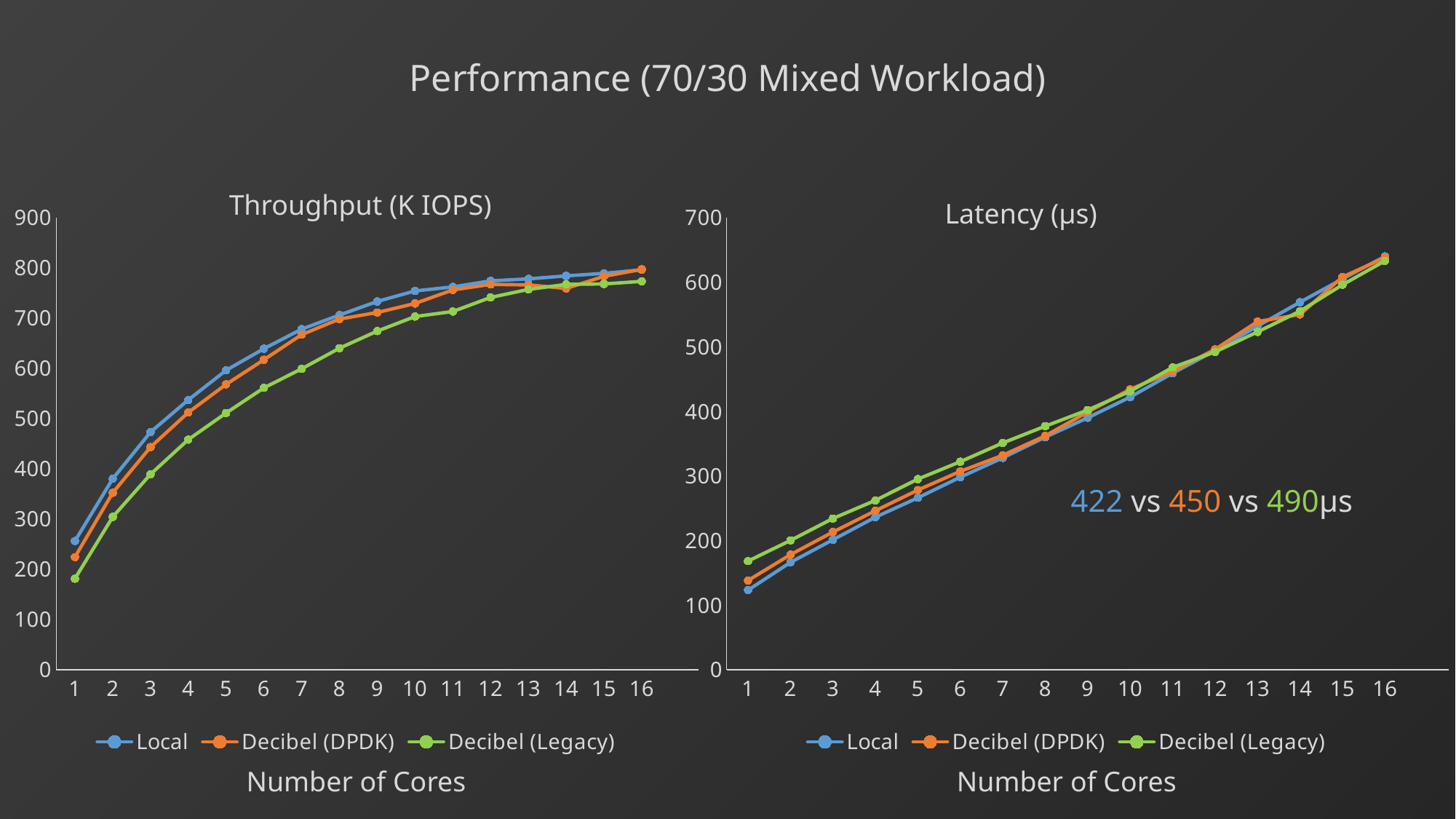
What kind of chart is the Throughput (K IOPS) chart? line chart In the Throughput (K IOPS) chart, which series has the highest value at 1 core? Local In the Throughput (K IOPS) chart, is the value for Decibel (Legacy) at 1 core greater or less than 300? less In the Latency (µs) chart, is the value for Local at 16 cores greater or less than 600? greater How many core counts are plotted along the x axis of the Throughput (K IOPS) chart? 16 What is the x-axis label of the Latency (µs) chart? Number of Cores How many series does the legend of the Latency (µs) chart list? 3 In the Latency (µs) chart, which series has the highest value at 1 core? Decibel (Legacy) In the Throughput (K IOPS) chart, is the value for Local at 1 core greater or less than 200? greater In the Latency (µs) chart, do the values rise or fall as the number of cores increases? rise In the Throughput (K IOPS) chart, which series has the lowest value at 1 core? Decibel (Legacy) In the Throughput (K IOPS) chart, which is larger at 4 cores: Local or Decibel (Legacy)? Local